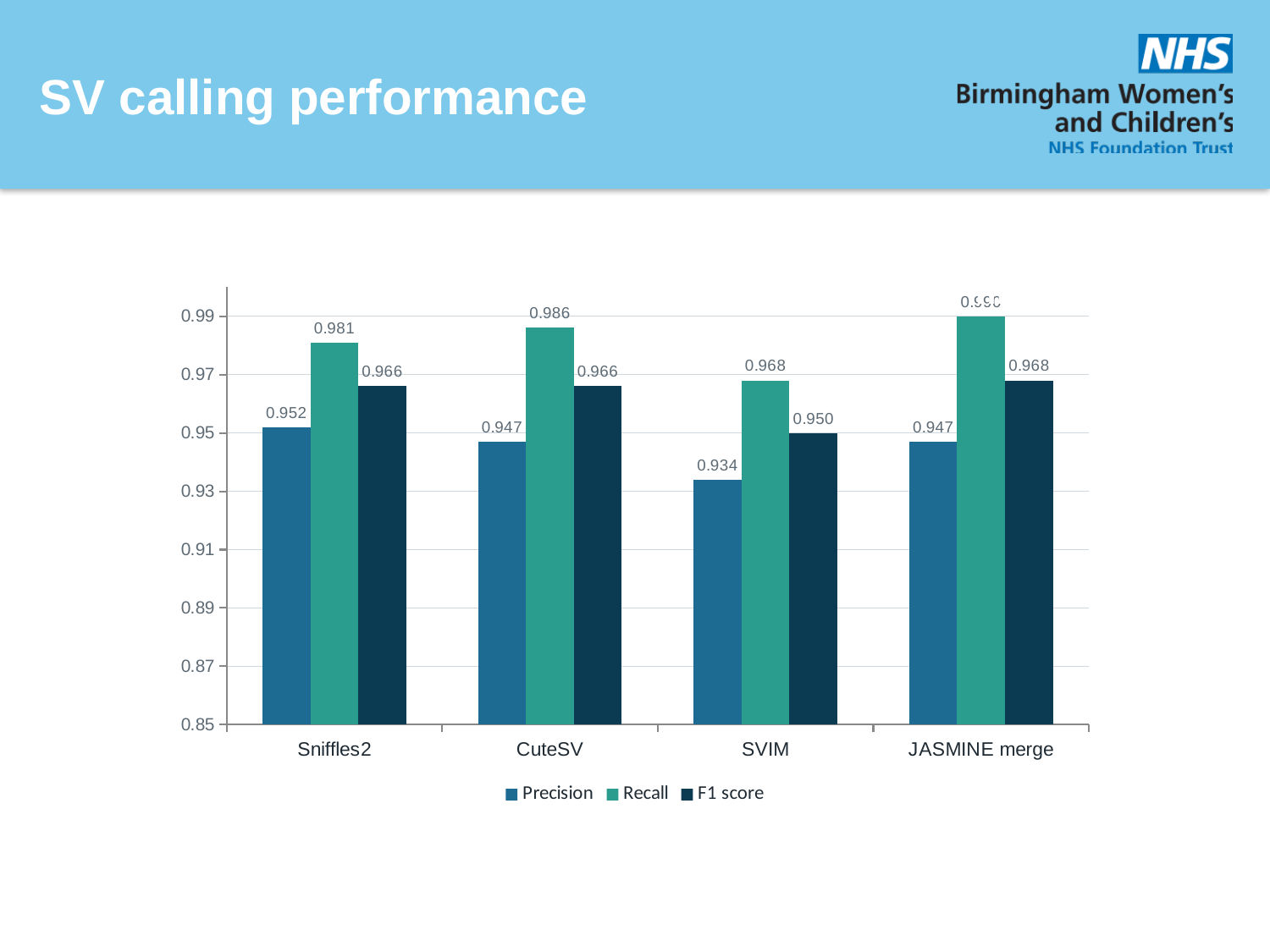
Is the Recall value for JASMINE merge greater or less than 0.97? greater What is the F1 score for SVIM? 0.950 What is the Precision value for Sniffles2? 0.952 Which tool has the highest Precision? Sniffles2 Which tool has the lowest Precision? SVIM Is the F1 score for Sniffles2 or for SVIM larger? Sniffles2 How many tools are compared on the x axis? 4 What kind of chart is shown on the slide? bar chart How many series does the legend list? 3 What is the Recall value for CuteSV? 0.986 What is the Precision value for JASMINE merge? 0.947 What is the difference between the Recall and Precision values for SVIM? 0.034